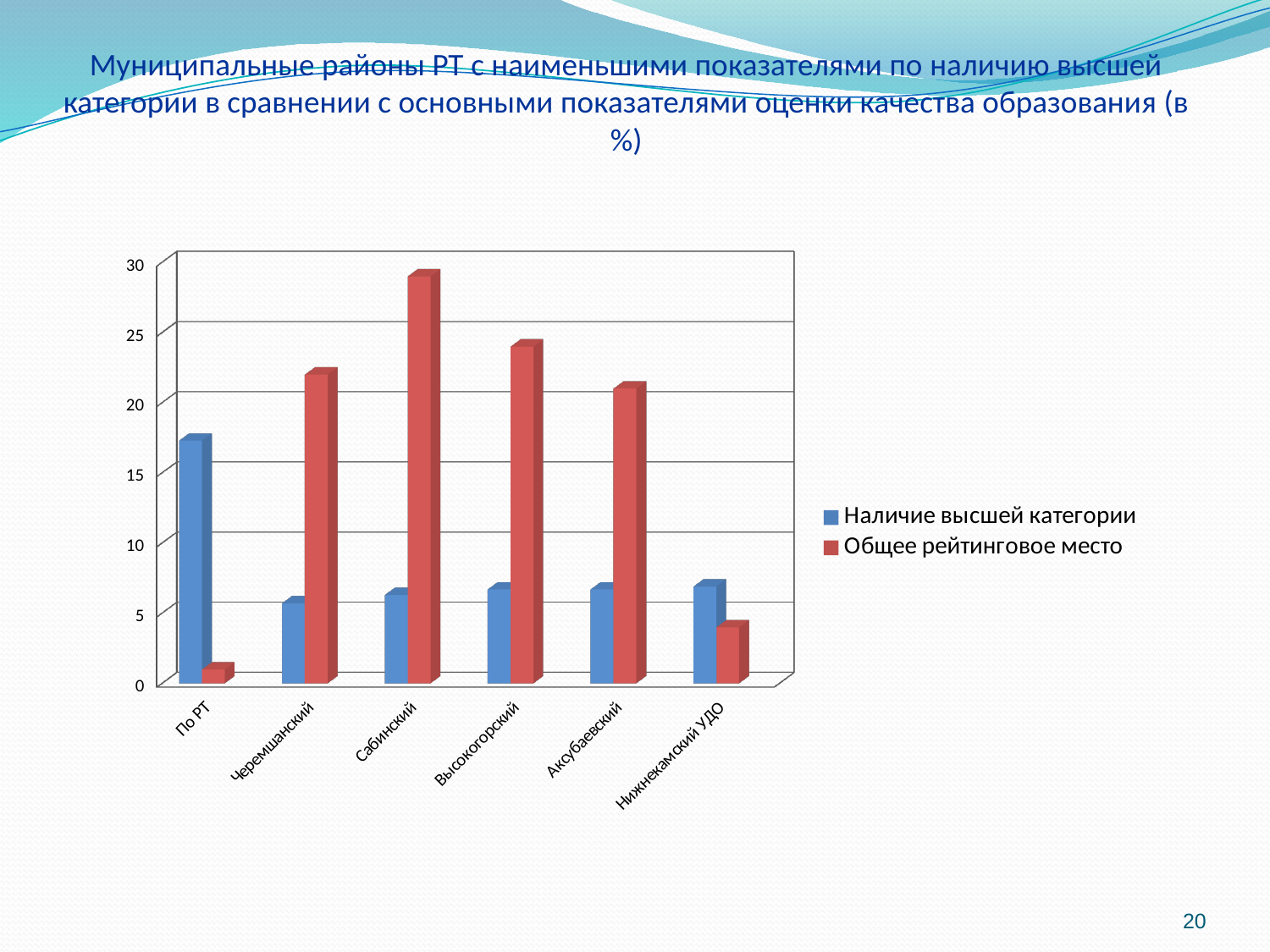
Which category has the lowest value for Общее рейтинговое место? По РТ Is the value of Общее рейтинговое место for Нижнекамский УДО greater or less than 5? less How many series does the chart's legend list? 2 Is the value of Общее рейтинговое место for Черемшанский greater or less than 20? greater What kind of chart is shown on the slide? bar chart How many categories are shown on the x axis of the chart? 6 Is the value of Наличие высшей категории for По РТ greater or less than 15? greater Which category has the highest value for Общее рейтинговое место? Сабинский Which category has the highest value for Наличие высшей категории? По РТ Which series is shown in red in the chart's legend? Общее рейтинговое место Which is larger: Общее рейтинговое место for Сабинский or for Высокогорский? Сабинский